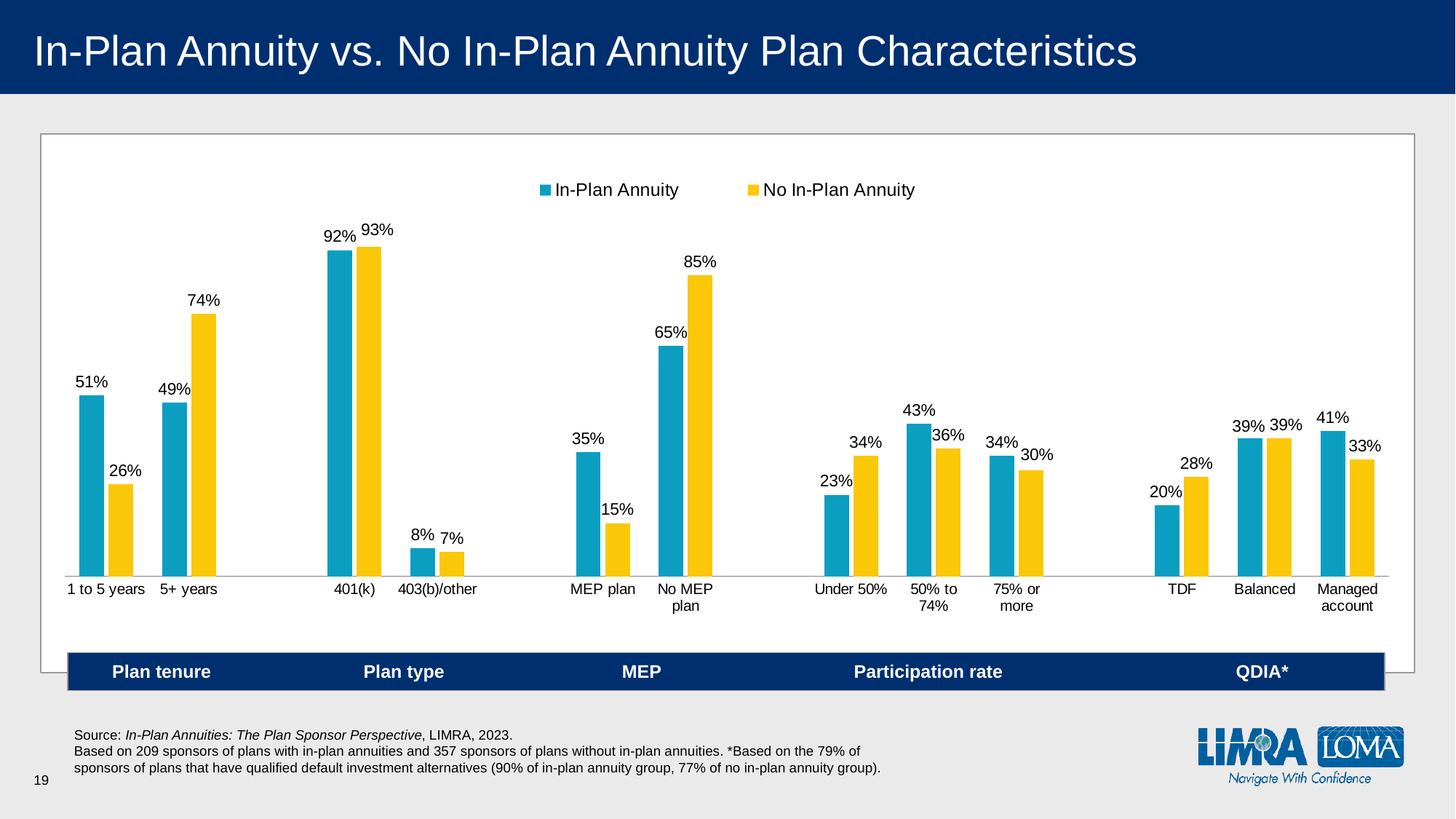
What is the In-Plan Annuity value for TDF? 20% Which category has the highest In-Plan Annuity value? 401(k) How many series does the legend list? 2 Which category has the lowest No In-Plan Annuity value? 403(b)/other What is the difference between the In-Plan Annuity and No In-Plan Annuity values for MEP plan? 20% What colour represents the No In-Plan Annuity series? Yellow What kind of chart is shown on the slide? Bar chart How many categories are shown on the x axis? 13 What is the No In-Plan Annuity value for No MEP plan? 85% What is the No In-Plan Annuity value for 5+ years? 74% What is the In-Plan Annuity value for 1 to 5 years? 51% Which is larger for Managed account: the In-Plan Annuity value or the No In-Plan Annuity value? In-Plan Annuity